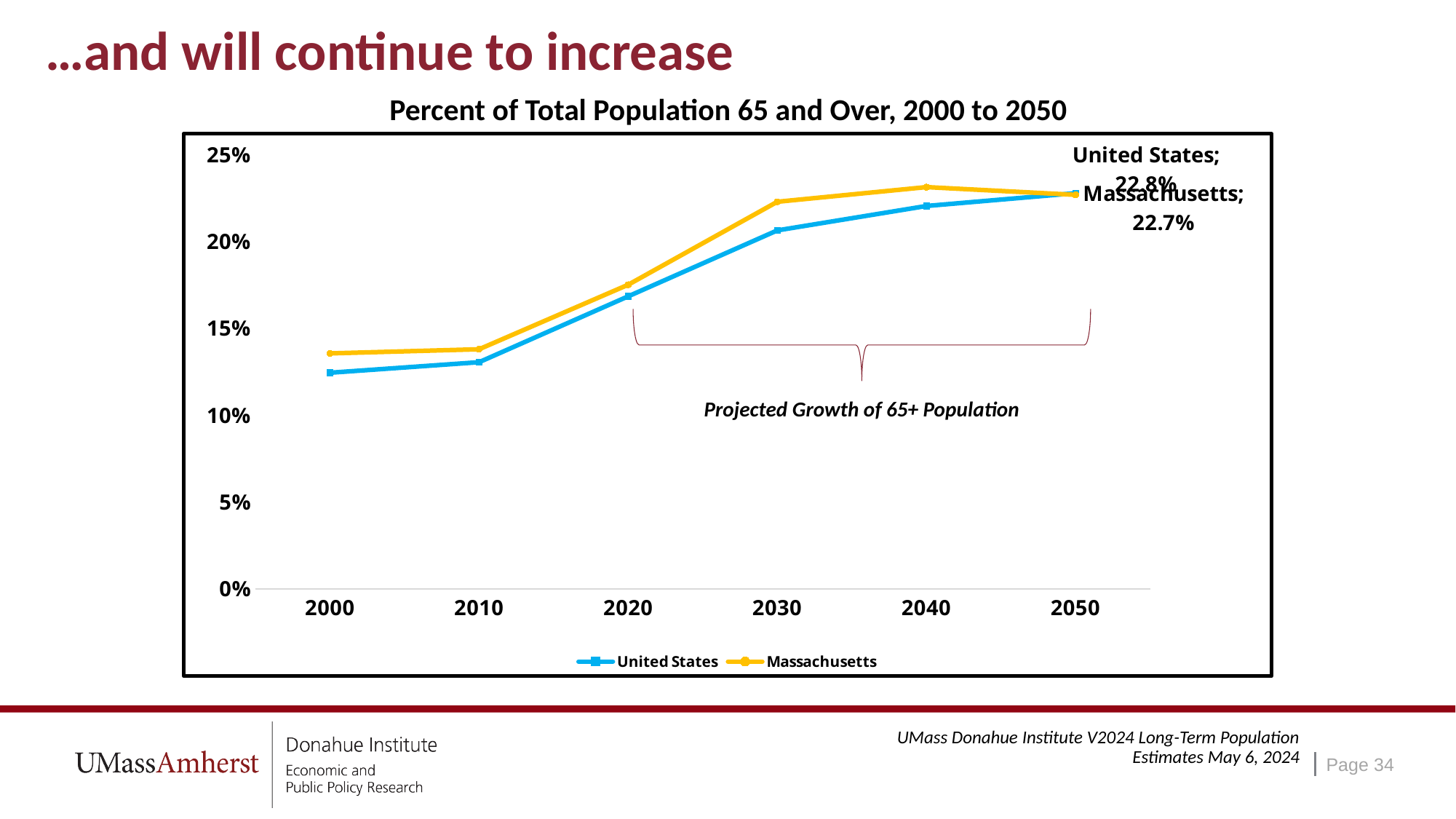
How many series does the legend list? 2 What kind of chart is shown on the slide? Line chart In 2030, which series has the higher value, United States or Massachusetts? Massachusetts Do the values for Massachusetts generally rise or fall from 2000 to 2040? Rise In 2050, which series has the higher value, United States or Massachusetts? United States What is the value for Massachusetts in 2050? 22.7% What is the value for United States in 2050? 22.8% Is the value for United States in 2000 greater or less than 15%? less How many years are plotted along the x axis? 6 What is the title of the chart? Percent of Total Population 65 and Over, 2000 to 2050 What is the difference between the United States and Massachusetts values in 2050? 0.1% Is the value for Massachusetts in 2040 greater or less than 20%? greater